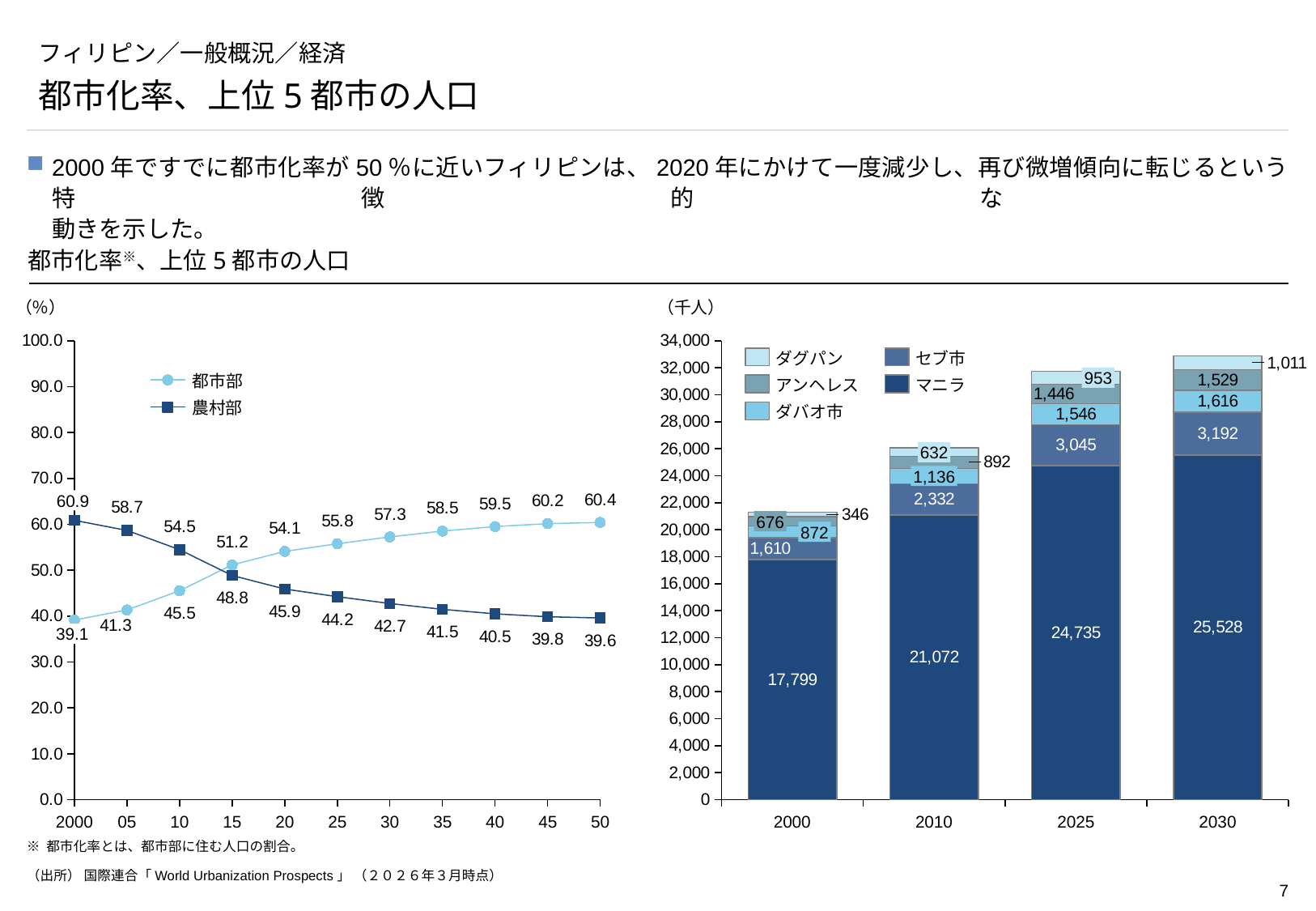
In the right stacked bar chart, how many series does the legend list? 5 In the left line chart, what is the difference between the 都市部 and 農村部 values in 2030? 14.6 In the right stacked bar chart, what is the total of the 2000 bar? 21,303 In the left line chart, does the 農村部 series rise or fall from 2000 to 2050? fall In the left line chart, what is the 農村部 value for 2050? 39.6 In the right stacked bar chart, what is the セブ市 value for 2010? 2,332 How many series does the legend of the left line chart list? 2 In the left line chart, what is the 都市部 value for 2000? 39.1 In the right stacked bar chart, what is the マニラ value for 2030? 25,528 What kind of chart is shown on the right side of the slide? stacked bar chart In the right stacked bar chart, which year has the highest マニラ value? 2030